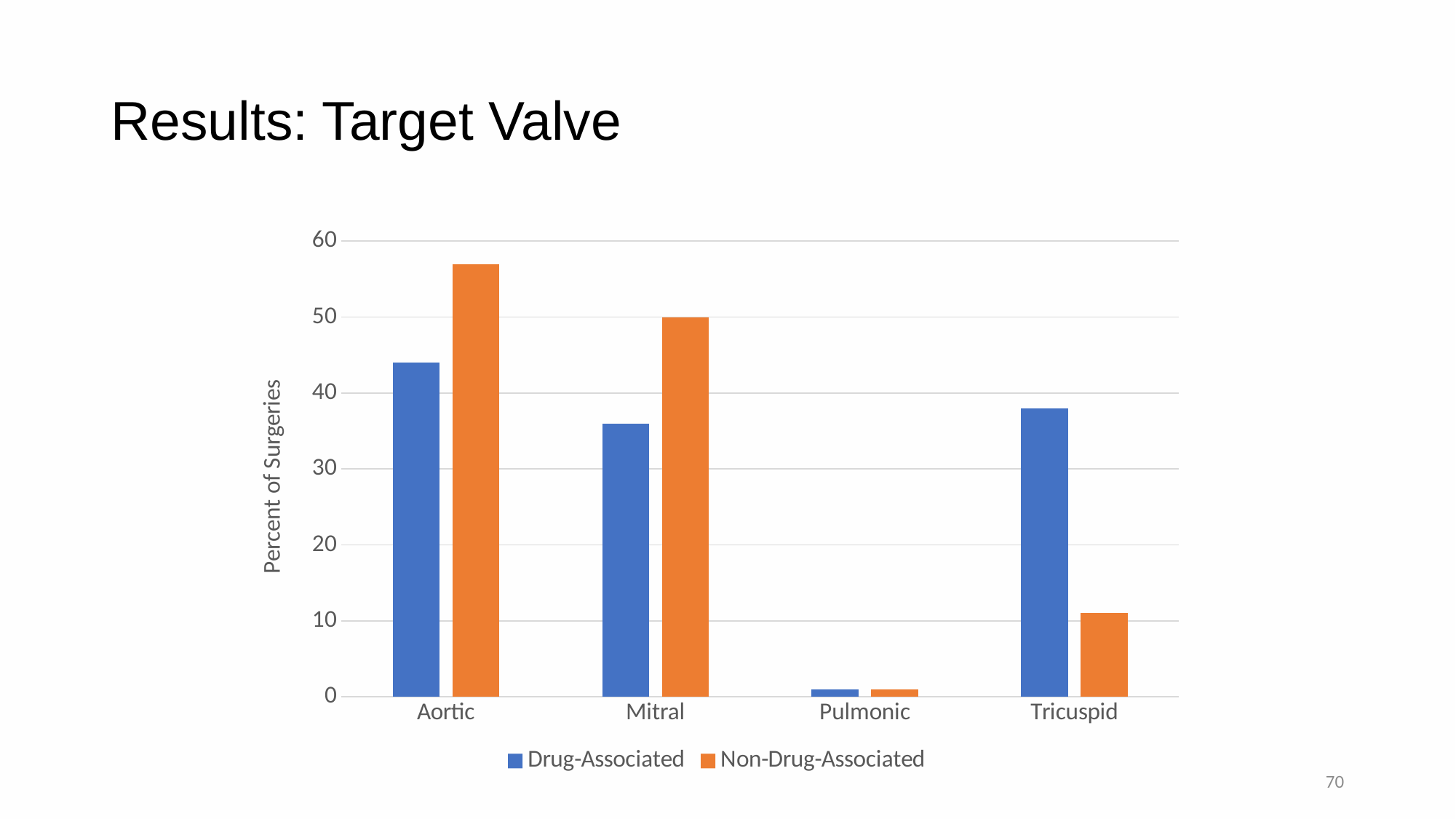
How many valve categories are shown on the x axis? 4 Is the Non-Drug-Associated value for Aortic greater or less than 50? greater For Mitral, which series has the larger value, Drug-Associated or Non-Drug-Associated? Non-Drug-Associated Which valve has the highest Non-Drug-Associated percentage? Aortic Which colour represents the Non-Drug-Associated series? orange For Tricuspid, which series has the larger value, Drug-Associated or Non-Drug-Associated? Drug-Associated What is the label of the y axis? Percent of Surgeries Is the Drug-Associated value for Tricuspid greater or less than 30? greater Which valve has the lowest Drug-Associated percentage? Pulmonic How many series does the legend list? 2 What type of chart is shown on the slide? bar chart Is the Non-Drug-Associated value for Tricuspid greater or less than 20? less